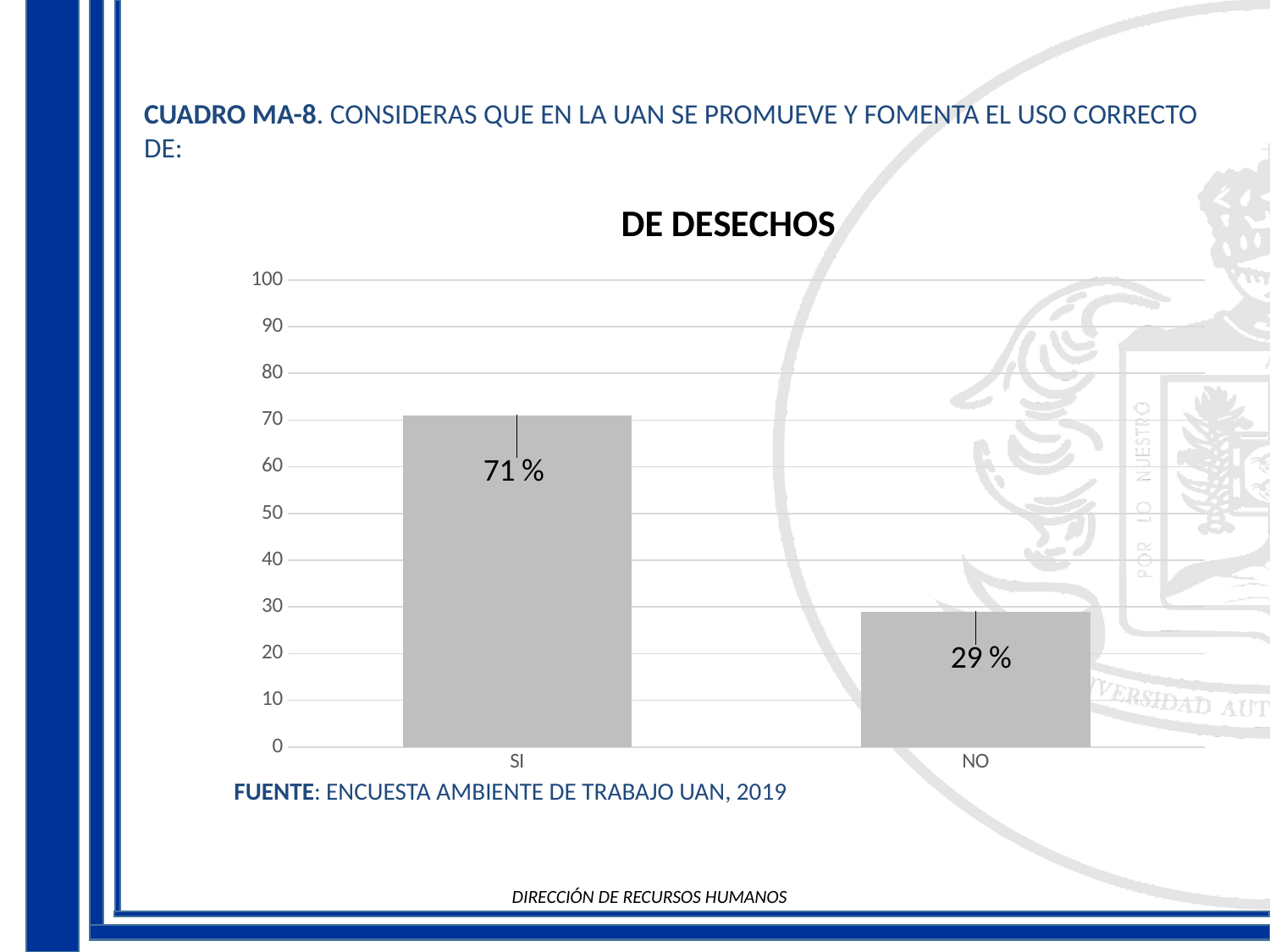
What is the title of the chart? DE DESECHOS Is the value for SI greater or less than 60? greater What is the value for SI? 71 % What is the difference between the values for SI and NO? 42 % Is the value for NO greater or less than 40? less Which category has the lowest value? NO How many categories are shown on the x axis? 2 Which category has the highest value? SI What kind of chart is shown? bar chart What is the value for NO? 29 % What is the maximum value shown on the y axis? 100 Which is larger, the value for SI or the value for NO? SI